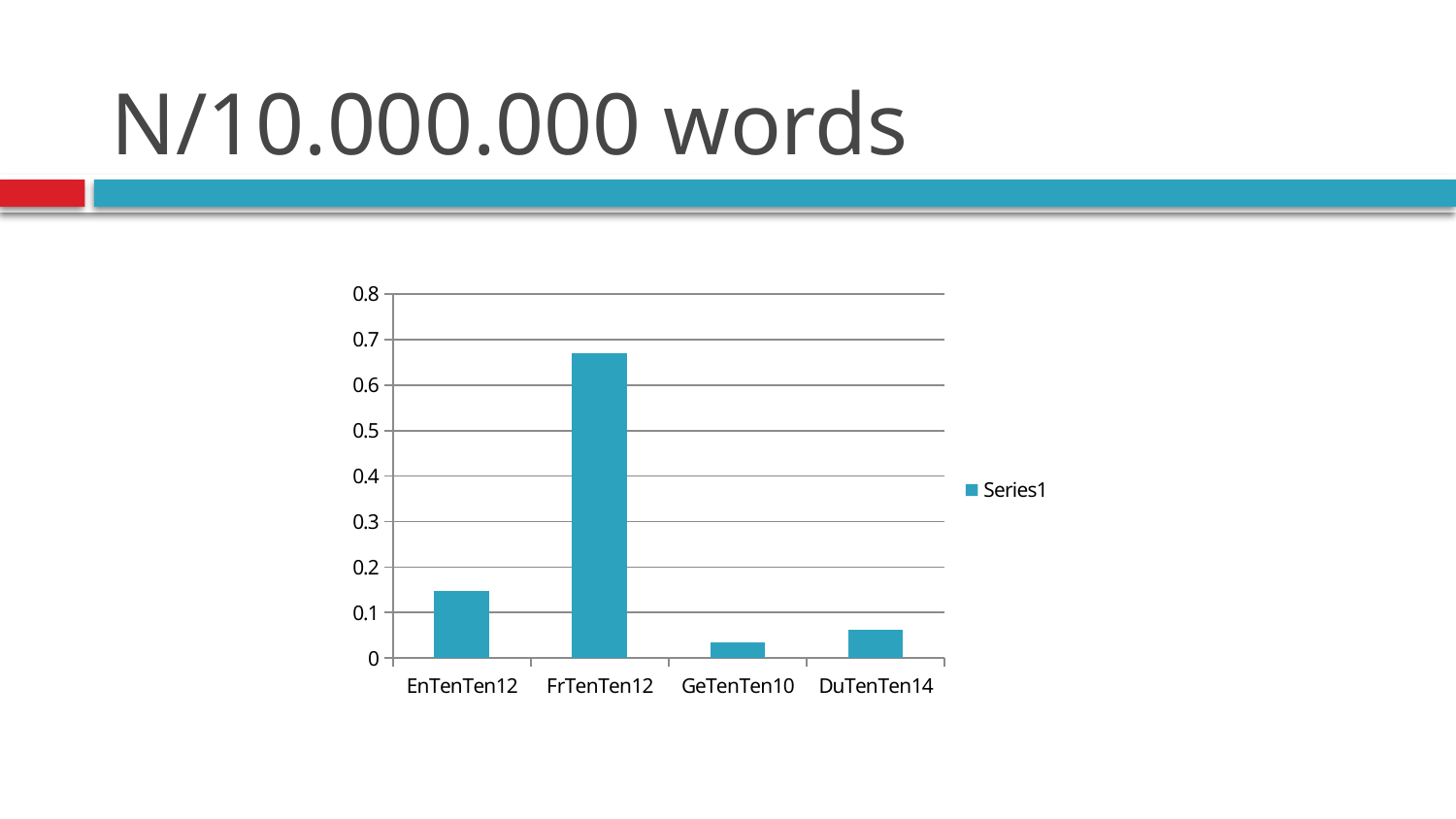
Which is larger, the value for EnTenTen12 or the value for DuTenTen14? EnTenTen12 Which category has the lowest bar in the chart? GeTenTen10 Which category has the highest bar in the chart? FrTenTen12 Is the value for DuTenTen14 greater or less than 0.1? less Is the value for FrTenTen12 greater or less than 0.6? greater Is the value for FrTenTen12 greater or less than 0.7? less What kind of chart is shown on the slide? bar chart How many series does the chart's legend list? 1 Which is larger, the value for GeTenTen10 or the value for FrTenTen12? FrTenTen12 How many categories are shown on the x axis of the chart? 4 What is the name of the series listed in the chart's legend? Series1